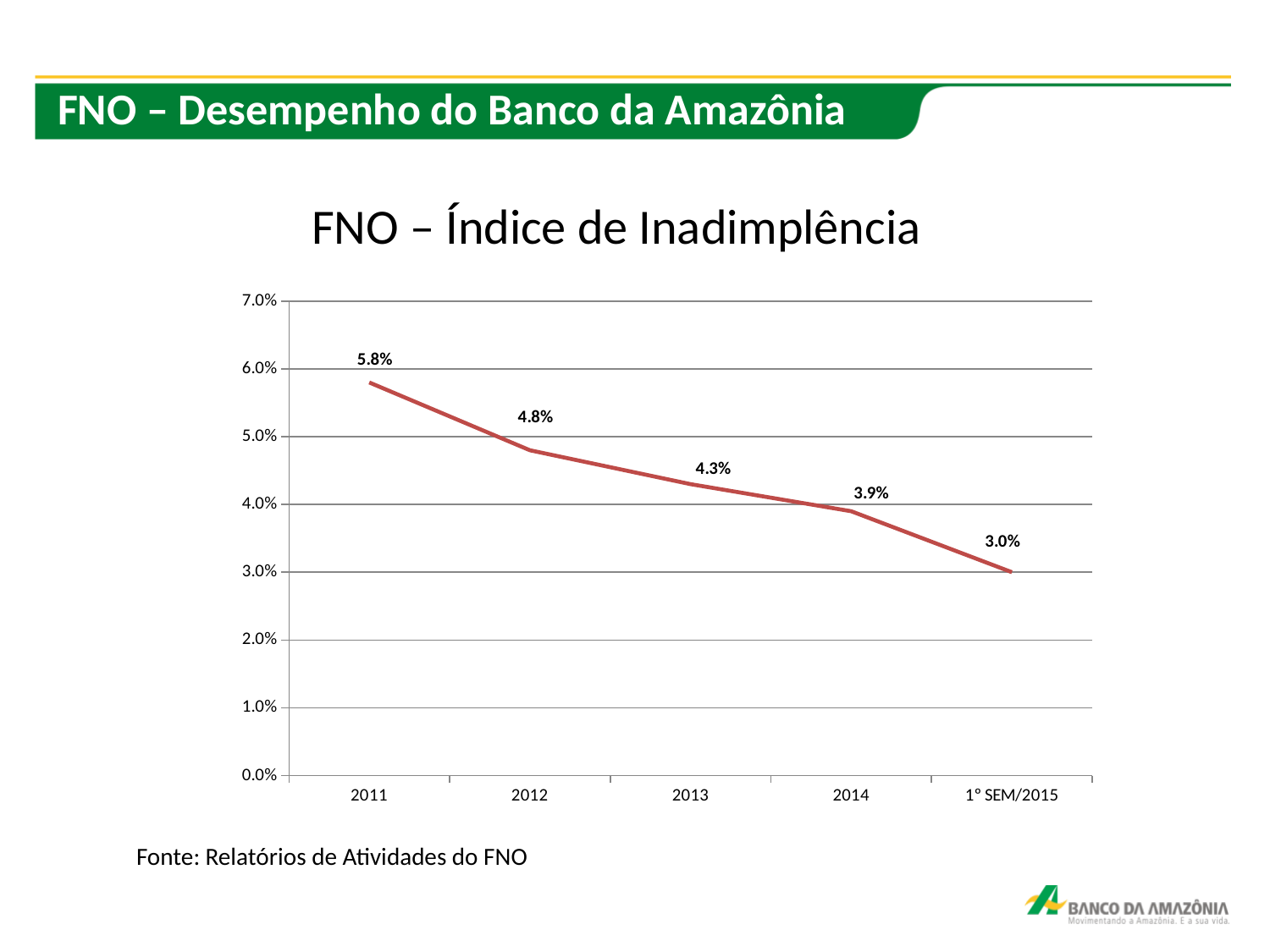
What is the value for 1° SEM/2015? 3.0% Do the values rise or fall from 2011 to 1° SEM/2015? fall What kind of chart is shown? line chart What is the difference between the values for 2011 and 2012? 1.0% What is the value for 2011? 5.8% How many periods are plotted on the x axis? 5 Which period has the lowest value? 1° SEM/2015 What is the value for 2013? 4.3% Which period has the highest value? 2011 Which is larger, the value for 2012 or the value for 2014? 2012 What is the difference between the values for 2014 and 1° SEM/2015? 0.9% Is the value for 2013 greater or less than 5.0%? less